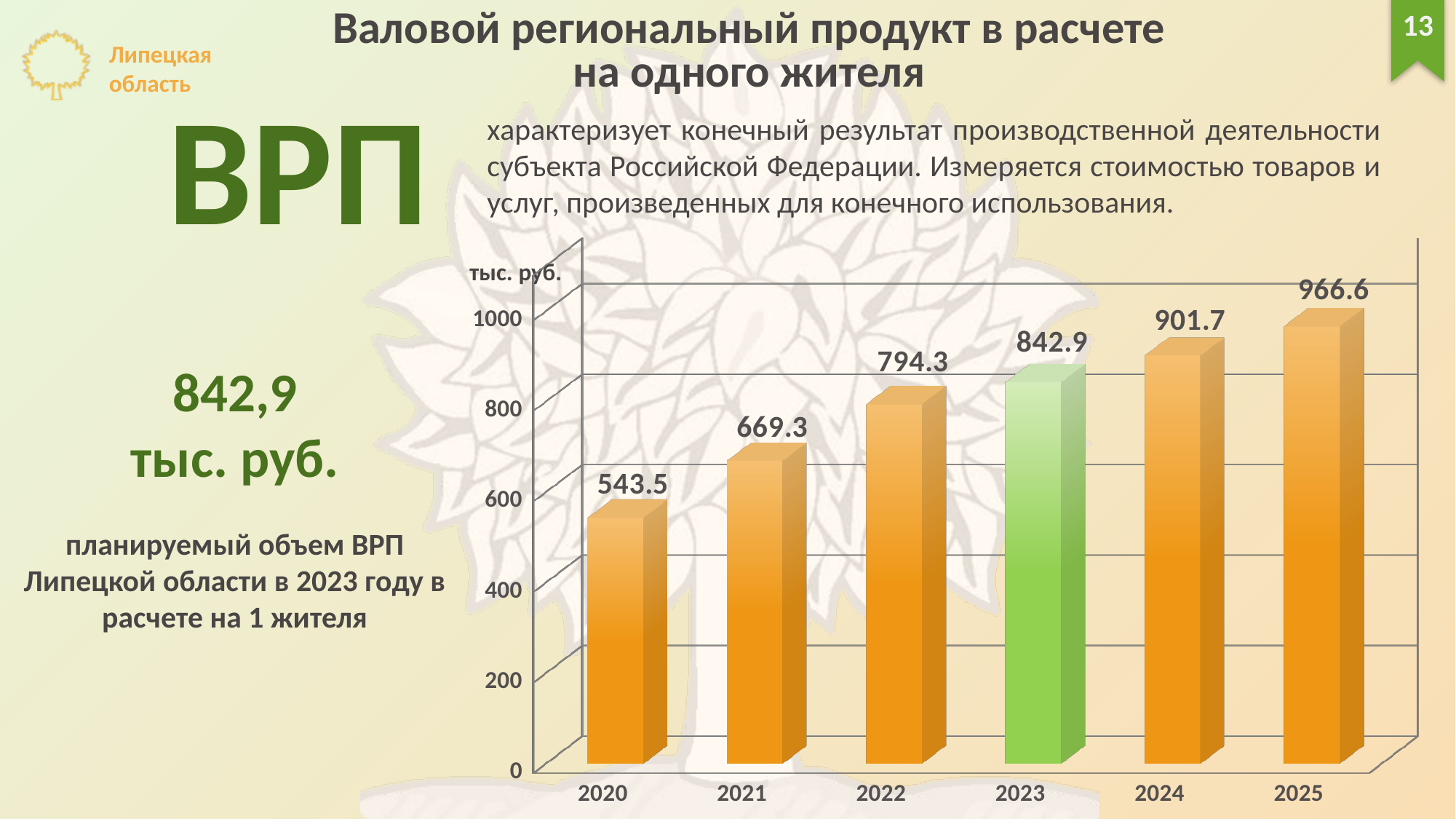
What is the difference between the values for 2025 and 2020? 423.1 What is the value for 2023? 842.9 What kind of chart is shown? bar chart Which year has the lowest value? 2020 What is the difference between the values for 2024 and 2023? 58.8 Which is larger, the value for 2021 or the value for 2022? 2022 What is the value for 2025? 966.6 Is the value for 2022 greater or less than 800? less Which year has the highest value? 2025 Do the values rise or fall from 2020 to 2025? rise How many years are shown on the x axis? 6 What is the value for 2020? 543.5